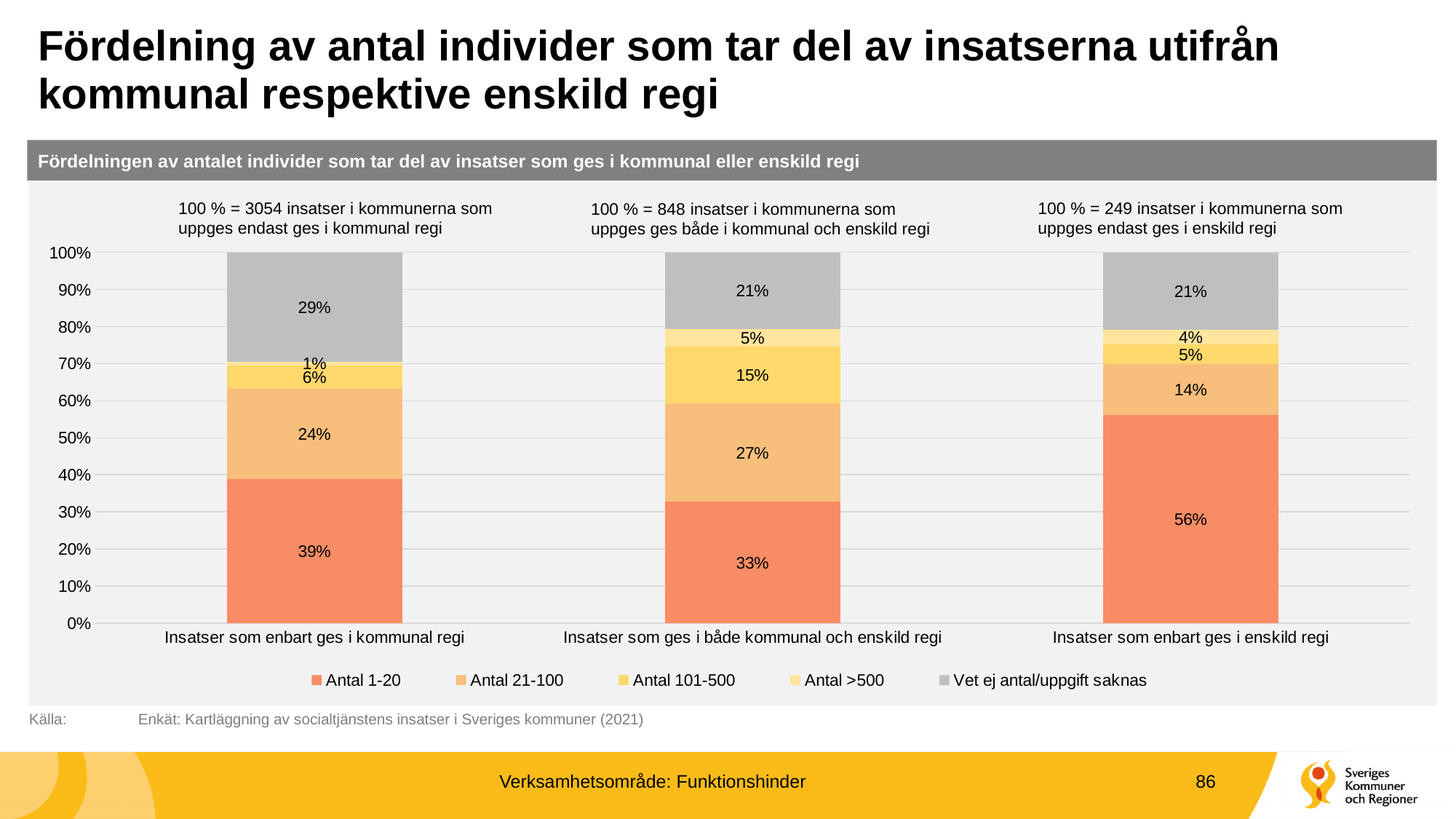
What is the value for Antal 21-100 in the bar 'Insatser som ges i både kommunal och enskild regi'? 27% Which category has the highest value for Antal 1-20? Insatser som enbart ges i enskild regi What kind of chart is shown on the slide? Stacked bar chart How many categories (bars) are shown on the x axis? 3 According to the text above the chart, how many insatser does 100 % correspond to for 'Insatser som ges i både kommunal och enskild regi'? 848 What is the value for Vet ej antal/uppgift saknas in the bar 'Insatser som enbart ges i kommunal regi'? 29% What is the value for Antal 1-20 in the bar 'Insatser som enbart ges i enskild regi'? 56% Which is larger: the Vet ej antal/uppgift saknas value for 'Insatser som enbart ges i kommunal regi' or for 'Insatser som enbart ges i enskild regi'? Insatser som enbart ges i kommunal regi Which category has the lowest value for Antal 21-100? Insatser som enbart ges i enskild regi What is the value for Antal 101-500 in the bar 'Insatser som ges i både kommunal och enskild regi'? 15% What is the difference between the Antal 1-20 values for 'Insatser som enbart ges i enskild regi' and 'Insatser som enbart ges i kommunal regi'? 17% How many series does the legend list? 5